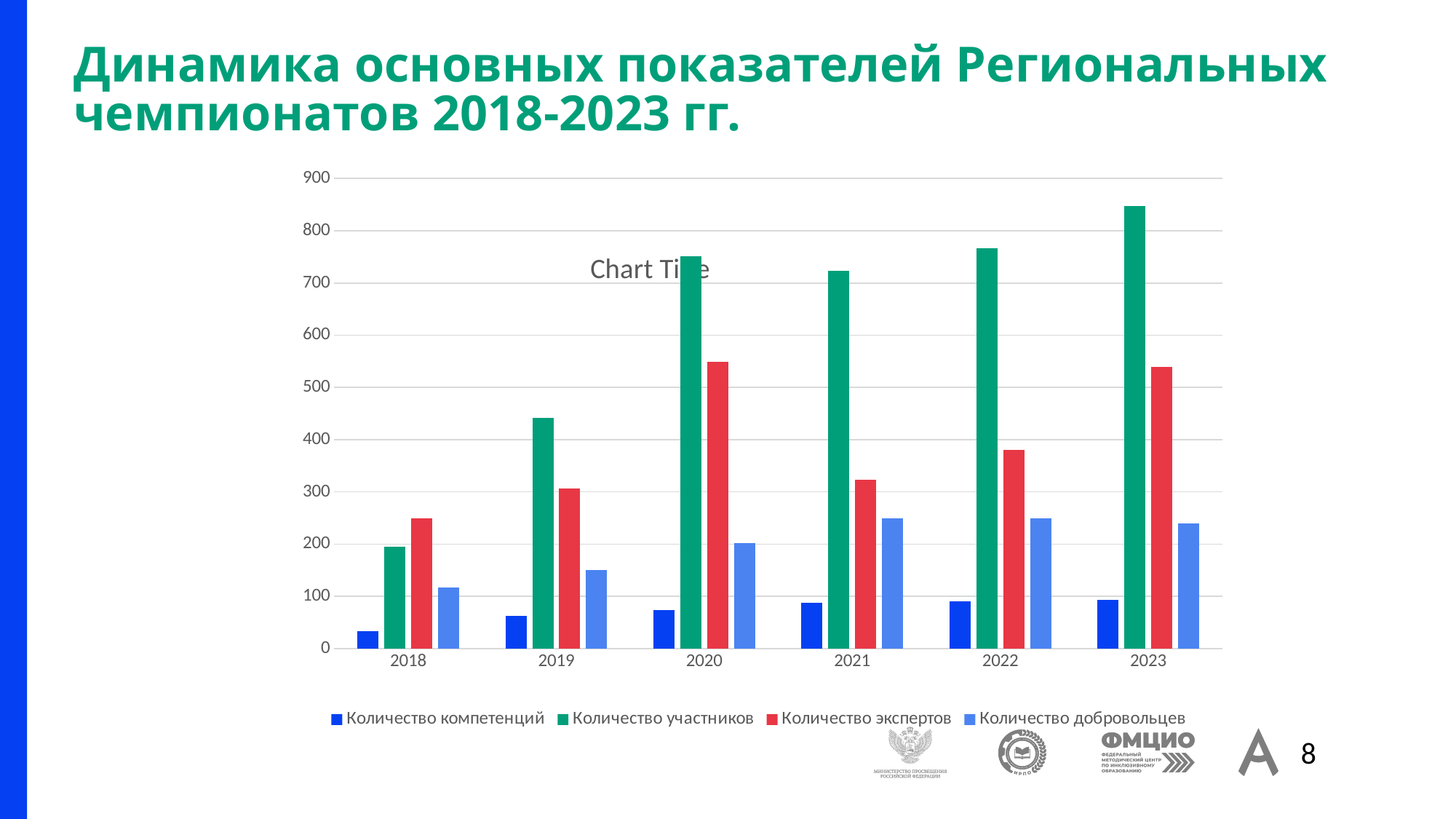
In which year is the value for Количество участников highest? 2023 Which year has the larger value for Количество экспертов, 2020 or 2022? 2020 Is the value for Количество участников in 2020 greater or less than 700? greater How many years are shown along the x axis? 6 How many series does the legend list? 4 Is the value for Количество добровольцев in 2021 greater or less than 200? greater Which series is shown in green? Количество участников In which year is the value for Количество экспертов lowest? 2018 In which year is the value for Количество участников lowest? 2018 What kind of chart is shown on the slide? bar chart Do the values for Количество компетенций rise or fall from 2018 to 2023? rise Is the value for Количество экспертов in 2018 greater or less than 300? less